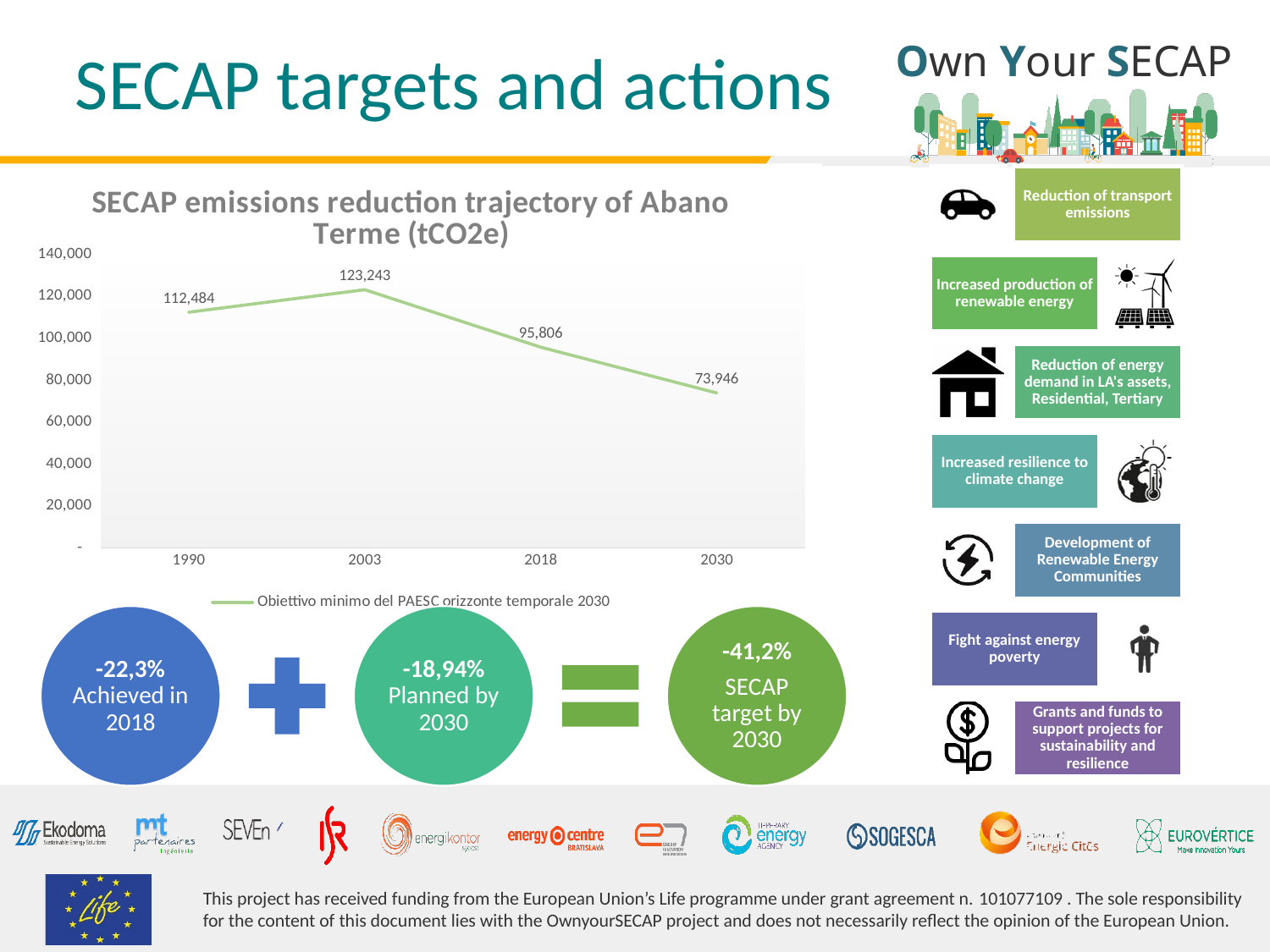
Which is larger in the SECAP emissions reduction trajectory chart, the value for 1990 or the value for 2018? 1990 Is the value for 2018 in the SECAP emissions reduction trajectory chart greater or less than 100,000? less Do the values in the SECAP emissions reduction trajectory chart rise or fall from 2003 to 2030? Fall What type of chart is the SECAP emissions reduction trajectory of Abano Terme? Line chart What is the emissions value for 2030 in the SECAP emissions reduction trajectory chart? 73,946 What is the emissions value for 2003 in the SECAP emissions reduction trajectory chart? 123,243 What is the emissions value for 1990 in the SECAP emissions reduction trajectory chart? 112,484 How many series does the legend of the SECAP emissions reduction trajectory chart list? 1 Which year has the highest emissions value in the SECAP emissions reduction trajectory chart? 2003 What is the difference between the 2018 and 2030 values in the SECAP emissions reduction trajectory chart? 21,860 Which year has the lowest emissions value in the SECAP emissions reduction trajectory chart? 2030 How many data points are plotted in the SECAP emissions reduction trajectory chart? 4